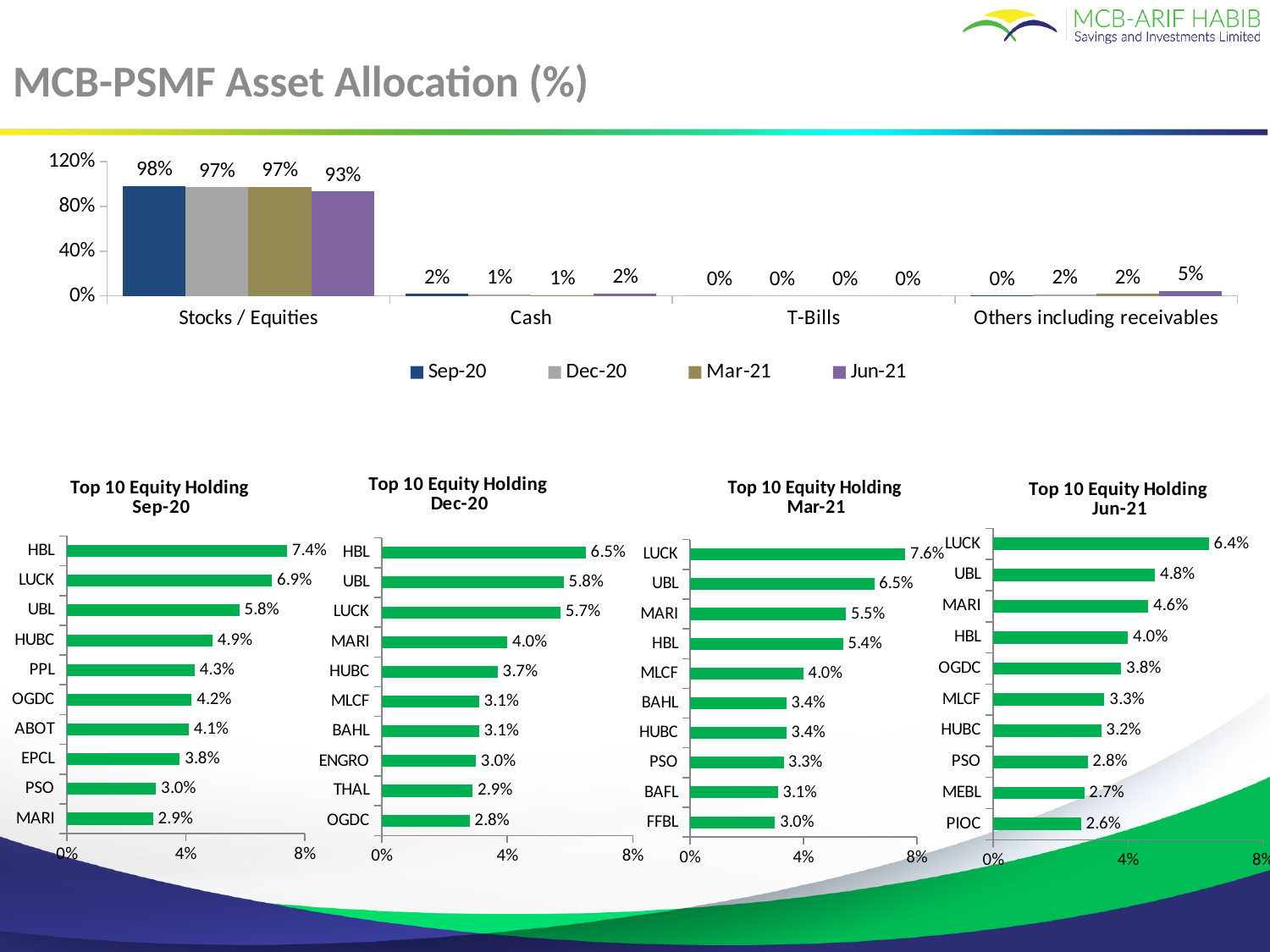
In the top asset allocation chart, what is the Stocks / Equities value for Jun-21? 93% In the top asset allocation chart, what is the Cash value for Dec-20? 1% In the Top 10 Equity Holding Dec-20 chart, which holding has the highest value? HBL In the Top 10 Equity Holding Jun-21 chart, what is the difference between the values for LUCK and UBL? 1.6% In the top asset allocation chart, what is the difference between the Stocks / Equities values for Sep-20 and Jun-21? 5% In the top asset allocation chart, which series has the highest value for Others including receivables? Jun-21 What kind of chart is the Top 10 Equity Holding Sep-20 chart? Bar chart In the Top 10 Equity Holding Mar-21 chart, what is the value for LUCK? 7.6% In the Top 10 Equity Holding Jun-21 chart, which holding has the lowest value? PIOC In the Top 10 Equity Holding Mar-21 chart, which is larger, the value for MARI or the value for MLCF? MARI How many series does the legend of the top asset allocation chart list? 4 In the Top 10 Equity Holding Sep-20 chart, what is the value for HUBC? 4.9%